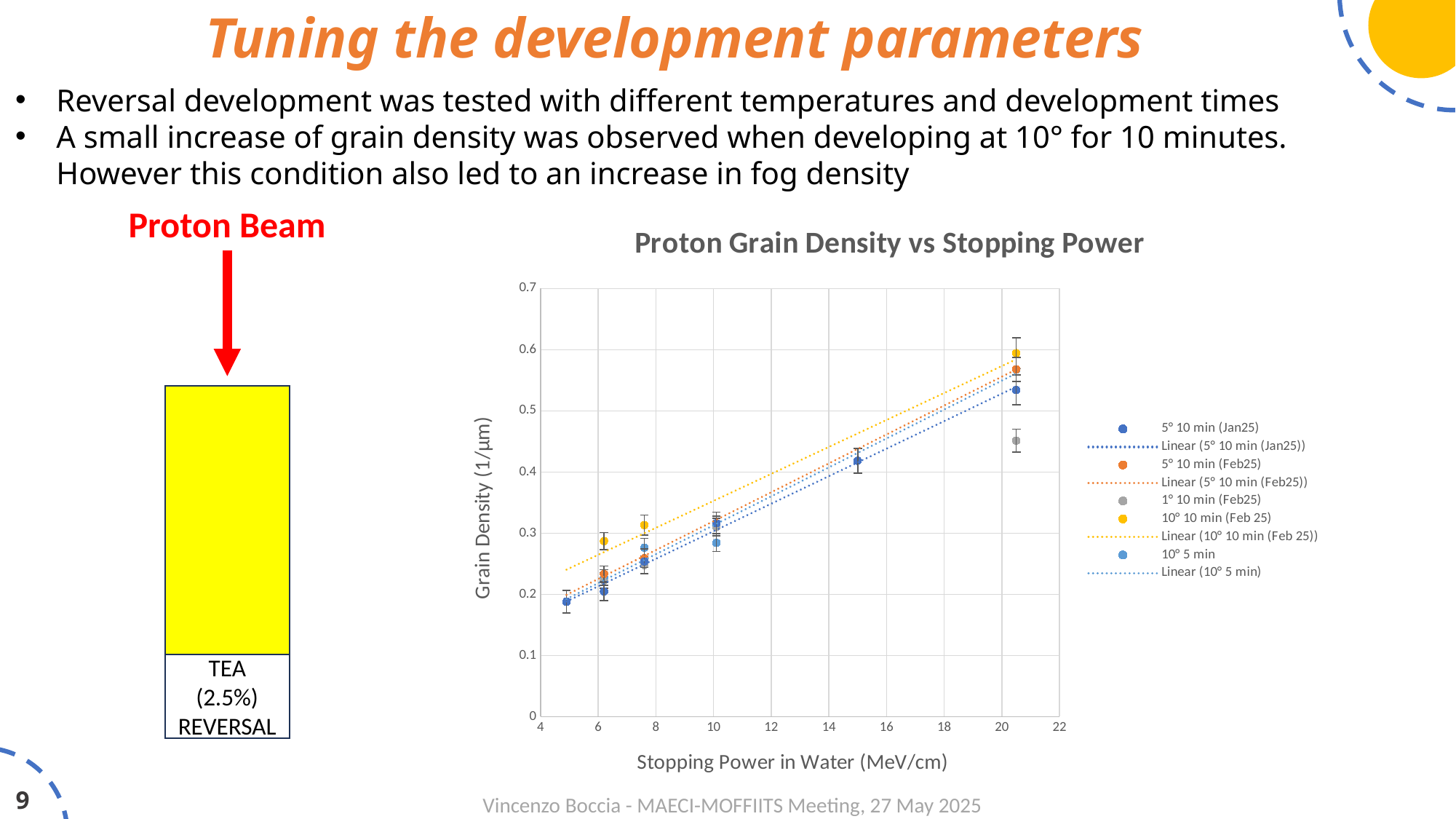
What is the highest tick value shown on the y axis of the chart? 0.7 At the highest stopping power (around 20.5 MeV/cm), which is larger: the value for 10° 10 min (Feb 25) or the value for 1° 10 min (Feb25)? 10° 10 min (Feb 25) What is the label of the y axis of the chart? Grain Density (1/μm) Is the value for the 1° 10 min (Feb25) series at the highest stopping power (around 20.5 MeV/cm) greater or less than 0.5? less How many entries does the chart legend list? 9 At the highest stopping power (around 20.5 MeV/cm), which series has the lowest grain density? 1° 10 min (Feb25) What is the title of the chart? Proton Grain Density vs Stopping Power Is the value for the 5° 10 min (Jan25) series at the lowest stopping power (around 5 MeV/cm) greater or less than 0.2? less What kind of chart is shown on the slide? Scatter chart Does grain density rise or fall as stopping power increases along the x axis? Rise Is the value for the 10° 10 min (Feb 25) series at the highest stopping power (around 20.5 MeV/cm) greater or less than 0.5? greater